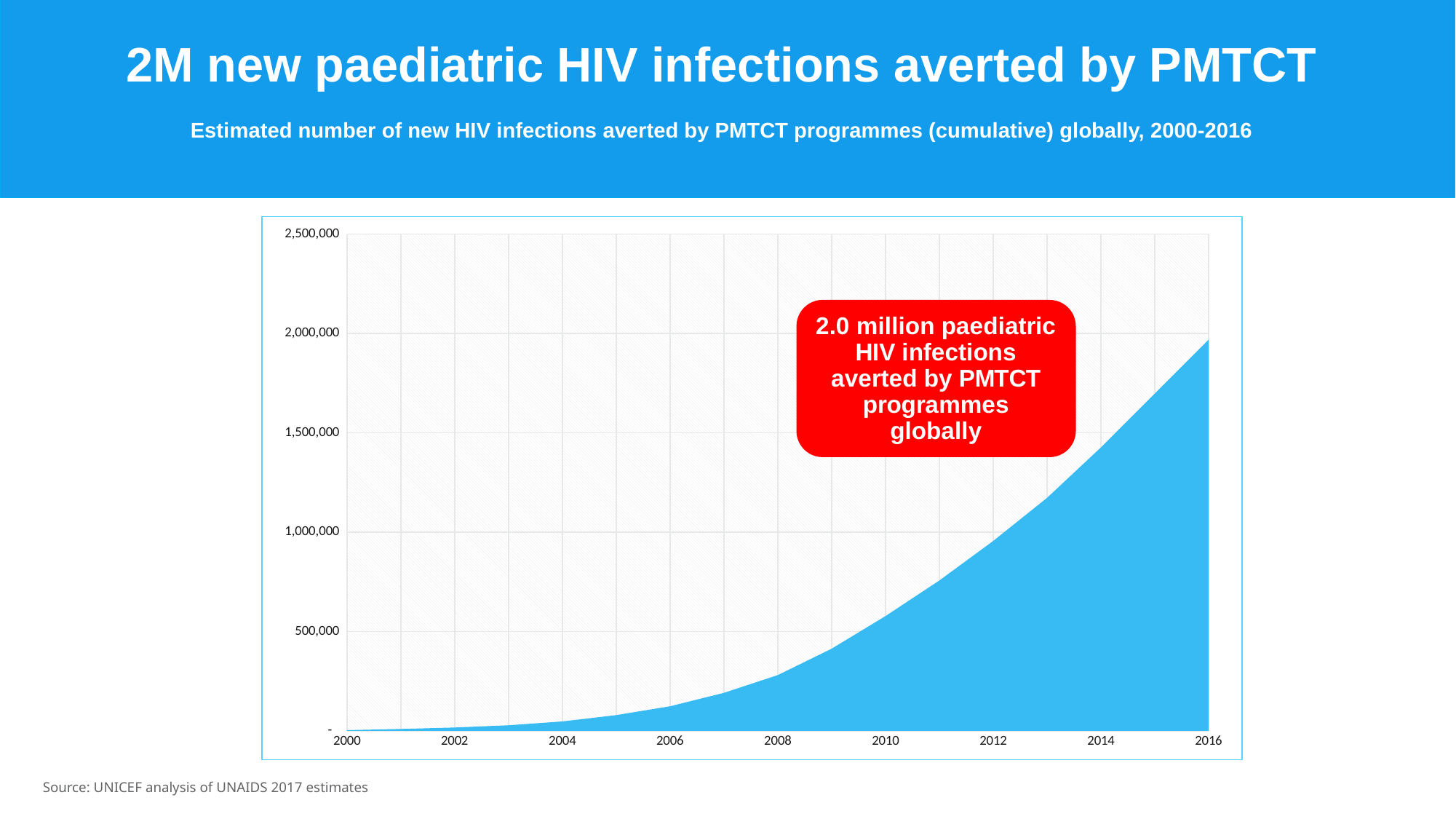
Is the value for 2008 greater or less than 500,000? less Is the value for 2016 greater or less than 1,500,000? greater Do the values rise or fall from 2000 to 2016? Rise In which year is the cumulative number of infections averted lowest? 2000 Is the value for 2014 greater or less than 1,000,000? greater According to the callout on the chart, how many paediatric HIV infections were averted by PMTCT programmes globally? 2.0 million How many year labels are shown on the x axis? 9 In which year is the cumulative number of infections averted highest? 2016 What kind of chart is shown on the slide? Area chart Which year has the larger value, 2006 or 2012? 2012